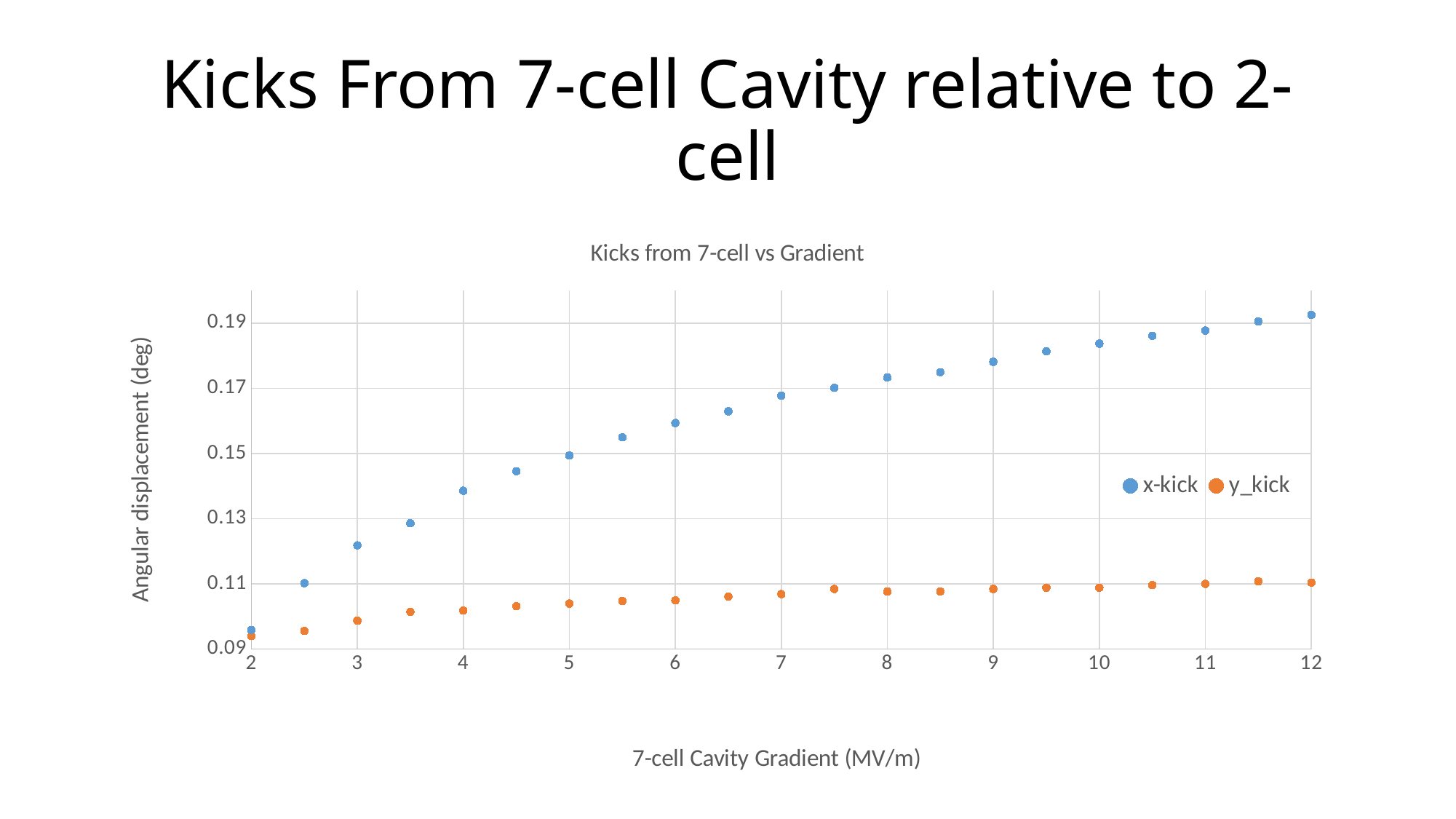
How many x-kick data points are plotted? 21 What is the label of the x axis? 7-cell Cavity Gradient (MV/m) Is the x-kick value at a gradient of 10 MV/m greater or less than 0.17? greater How many series does the legend list? 2 Is the y_kick value at a gradient of 2 MV/m greater or less than 0.11? less At a gradient of 8 MV/m, which is larger, x-kick or y_kick? x-kick Does the x-kick value rise or fall as the 7-cell cavity gradient increases? rise Is the x-kick value at a gradient of 6 MV/m greater or less than 0.15? greater What kind of chart is shown on the slide? scatter chart What is the title of the chart? Kicks from 7-cell vs Gradient Does the y_kick value rise or fall as the 7-cell cavity gradient increases? rise At which gradient is the x-kick value lowest? 2